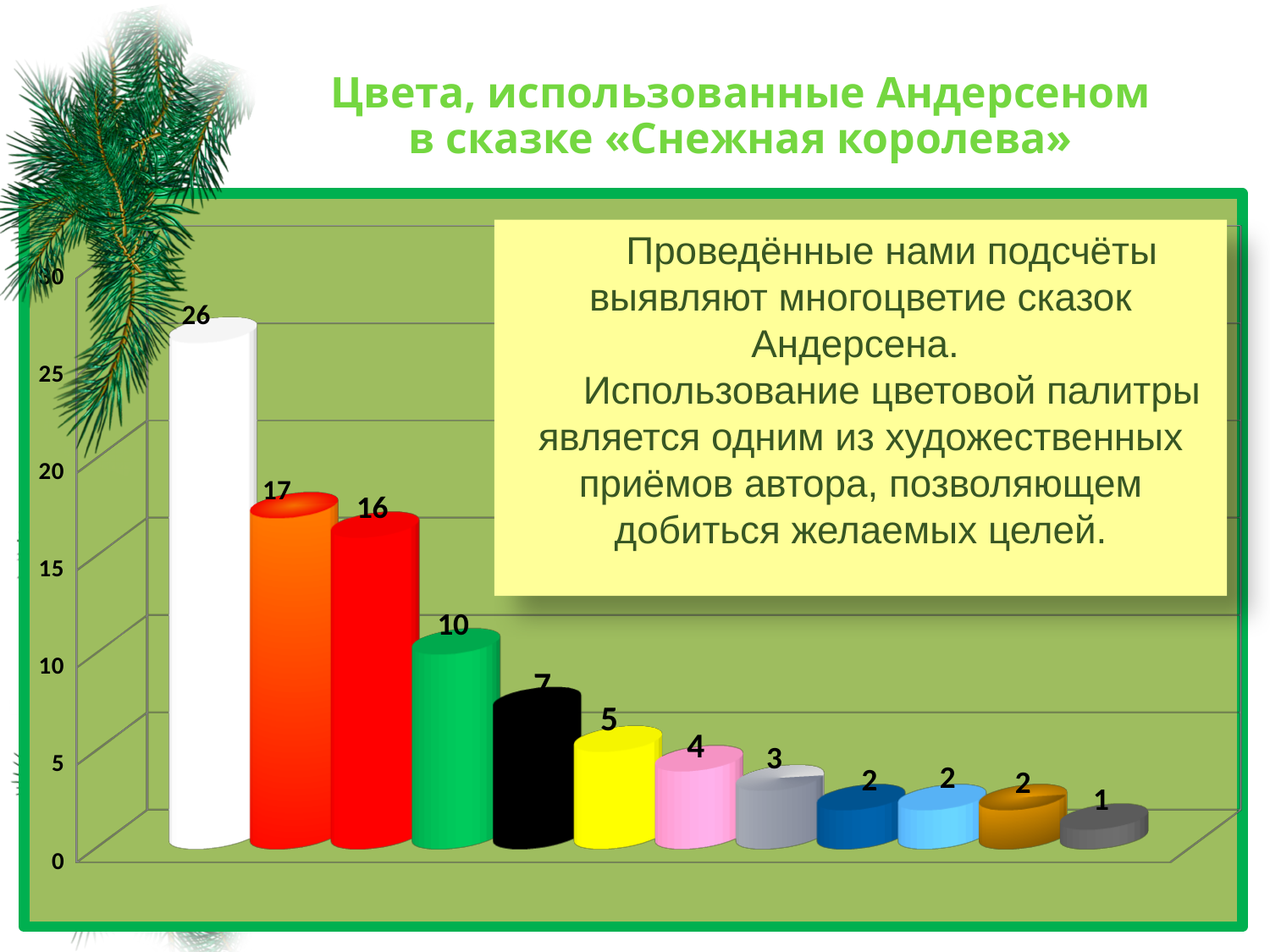
What is the value of the shortest (grey, rightmost) bar? 1 What is the value of the tallest (white) bar? 26 What is the title of the chart? Цвета, использованные Андерсеном в сказке «Снежная королева» Is the value of the white bar greater or less than 25? greater What is the difference between the white bar (26) and the orange bar (17)? 9 What kind of chart is shown on the slide? bar chart What is the value of the yellow bar? 5 What is the value of the green bar? 10 Do the bar values rise or fall from left to right? fall Which is larger, the orange bar or the red bar next to it? the orange bar How many bars does the chart have? 12 What is the value of the black bar? 7